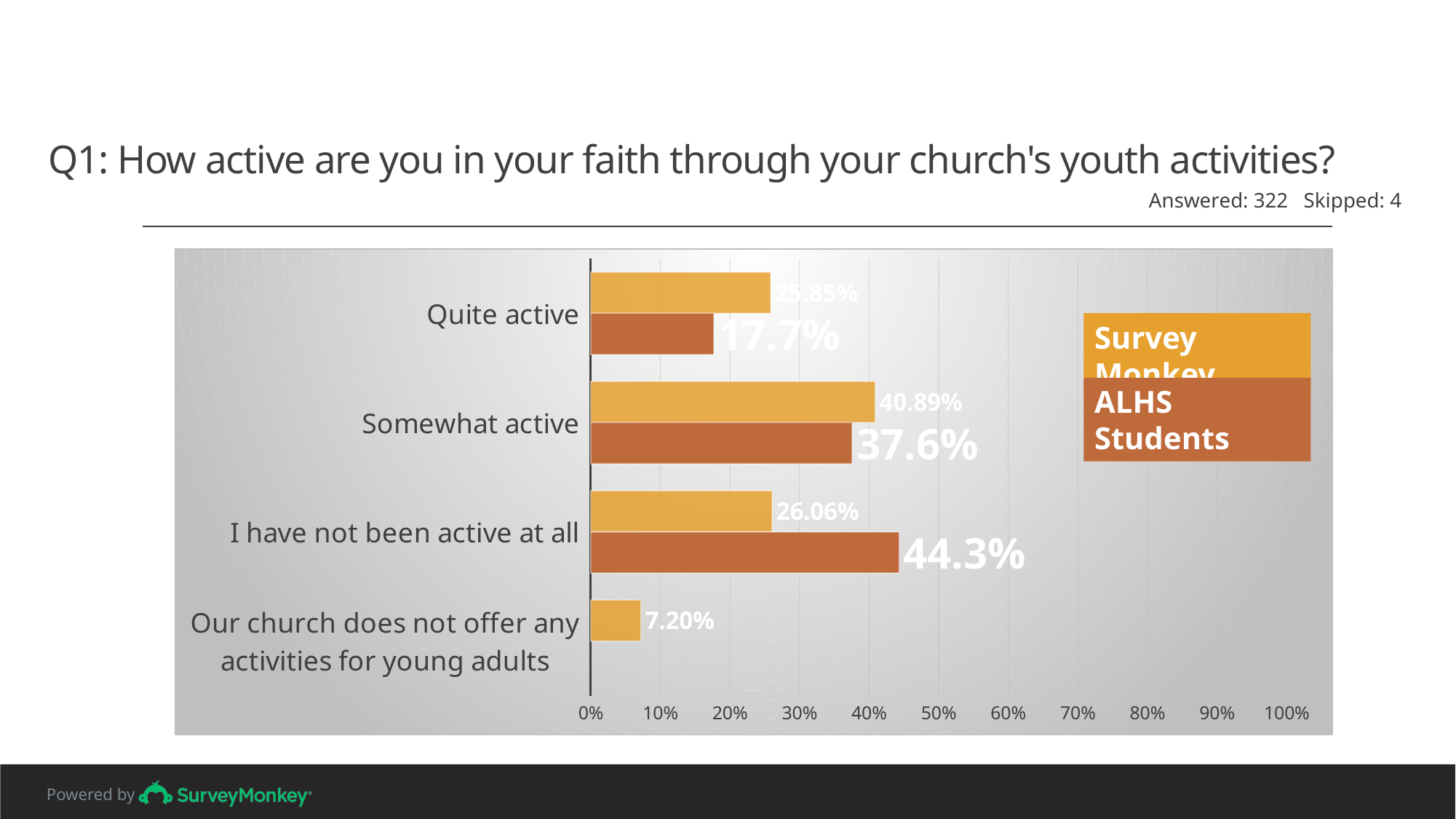
What is the ALHS Students value for "I have not been active at all"? 44.3% What is the Survey Monkey value for "Our church does not offer any activities for young adults"? 7.20% What is the ALHS Students value for "Quite active"? 17.7% What is the Survey Monkey value for "Somewhat active"? 40.89% Which category has the lowest Survey Monkey value? Our church does not offer any activities for young adults What is the difference between the ALHS Students value and the Survey Monkey value for "I have not been active at all"? 18.24% How many categories are shown on the chart? 4 Which category has the highest Survey Monkey value? Somewhat active Which category has the highest ALHS Students value? I have not been active at all For "I have not been active at all", which series has the larger value, Survey Monkey or ALHS Students? ALHS Students What kind of chart is shown on the slide? Bar chart How many series does the legend list? 2